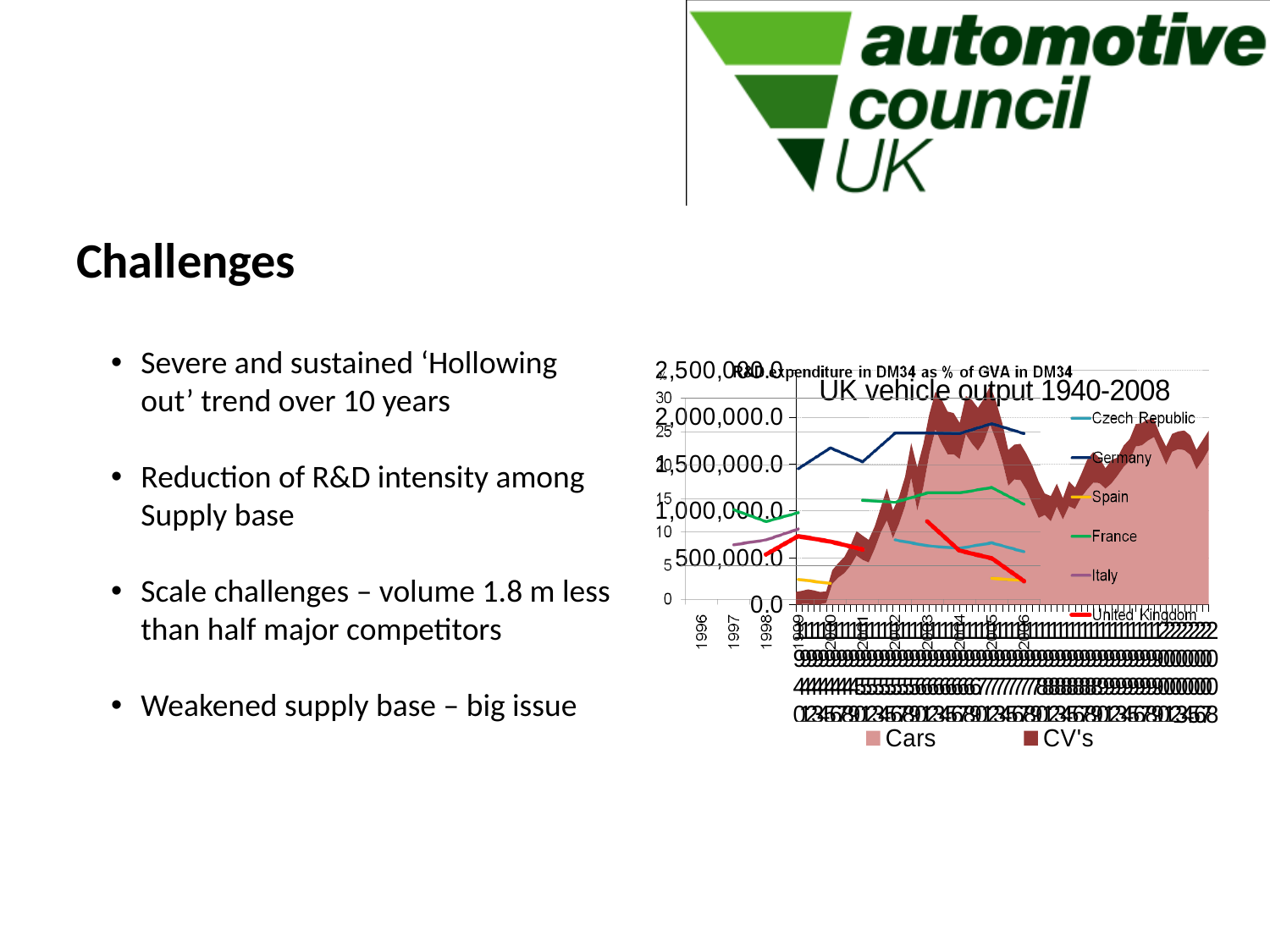
In the 'R&D expenditure in DM34 as % of GVA in DM34' chart, which is larger, the value for Germany or the value for France? Germany What kind of chart is the 'R&D expenditure in DM34 as % of GVA in DM34' chart? line chart In the 'R&D expenditure in DM34 as % of GVA in DM34' chart, is the value for Spain greater or less than 5? less In the 'R&D expenditure in DM34 as % of GVA in DM34' chart, which country has the lowest line? Spain In the 'UK vehicle output 1940-2008' chart, which series accounts for the larger share of output, Cars or CV's? Cars In the 'R&D expenditure in DM34 as % of GVA in DM34' chart, which country has the highest line? Germany How many series does the legend of the 'R&D expenditure in DM34 as % of GVA in DM34' chart list? 6 In the 'R&D expenditure in DM34 as % of GVA in DM34' chart, is the value for Germany greater or less than 15? greater What kind of chart is the 'UK vehicle output 1940-2008' chart? area chart What are the two legend entries of the 'UK vehicle output 1940-2008' chart? Cars and CV's How many series does the legend of the 'UK vehicle output 1940-2008' chart list? 2 In the 'R&D expenditure in DM34 as % of GVA in DM34' chart, does the United Kingdom line rise or fall over the years shown? fall